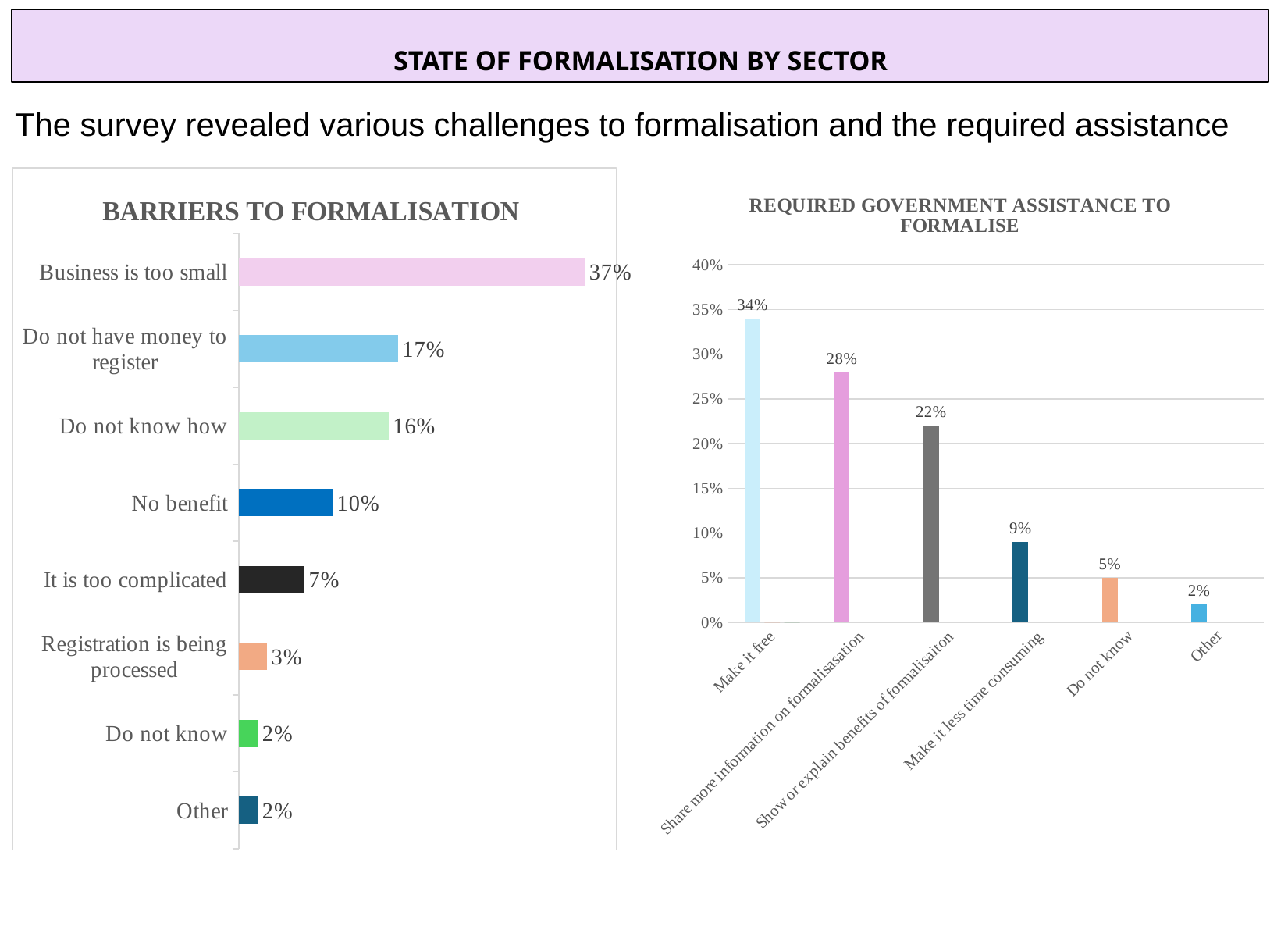
In the 'Required Government Assistance to Formalise' chart, which category has the lowest value? Other In the 'Barriers to Formalisation' chart, what is the value for 'No benefit'? 10% What kind of chart is the 'Required Government Assistance to Formalise' chart? bar chart In the 'Required Government Assistance to Formalise' chart, do the values rise or fall from left to right along the x axis? fall In the 'Required Government Assistance to Formalise' chart, what is the value for 'Make it free'? 34% In the 'Barriers to Formalisation' chart, which category has the highest value? Business is too small In the 'Barriers to Formalisation' chart, what is the value for 'Business is too small'? 37% In the 'Barriers to Formalisation' chart, how many categories are shown? 8 In the 'Barriers to Formalisation' chart, what is the difference between 'Do not have money to register' and 'Do not know how'? 1% In the 'Barriers to Formalisation' chart, which is larger: 'It is too complicated' or 'Registration is being processed'? It is too complicated In the 'Required Government Assistance to Formalise' chart, what is the difference between 'Share more information on formalisasation' and 'Show or explain benefits of formalisaiton'? 6% In the 'Required Government Assistance to Formalise' chart, what is the value for 'Make it less time consuming'? 9%